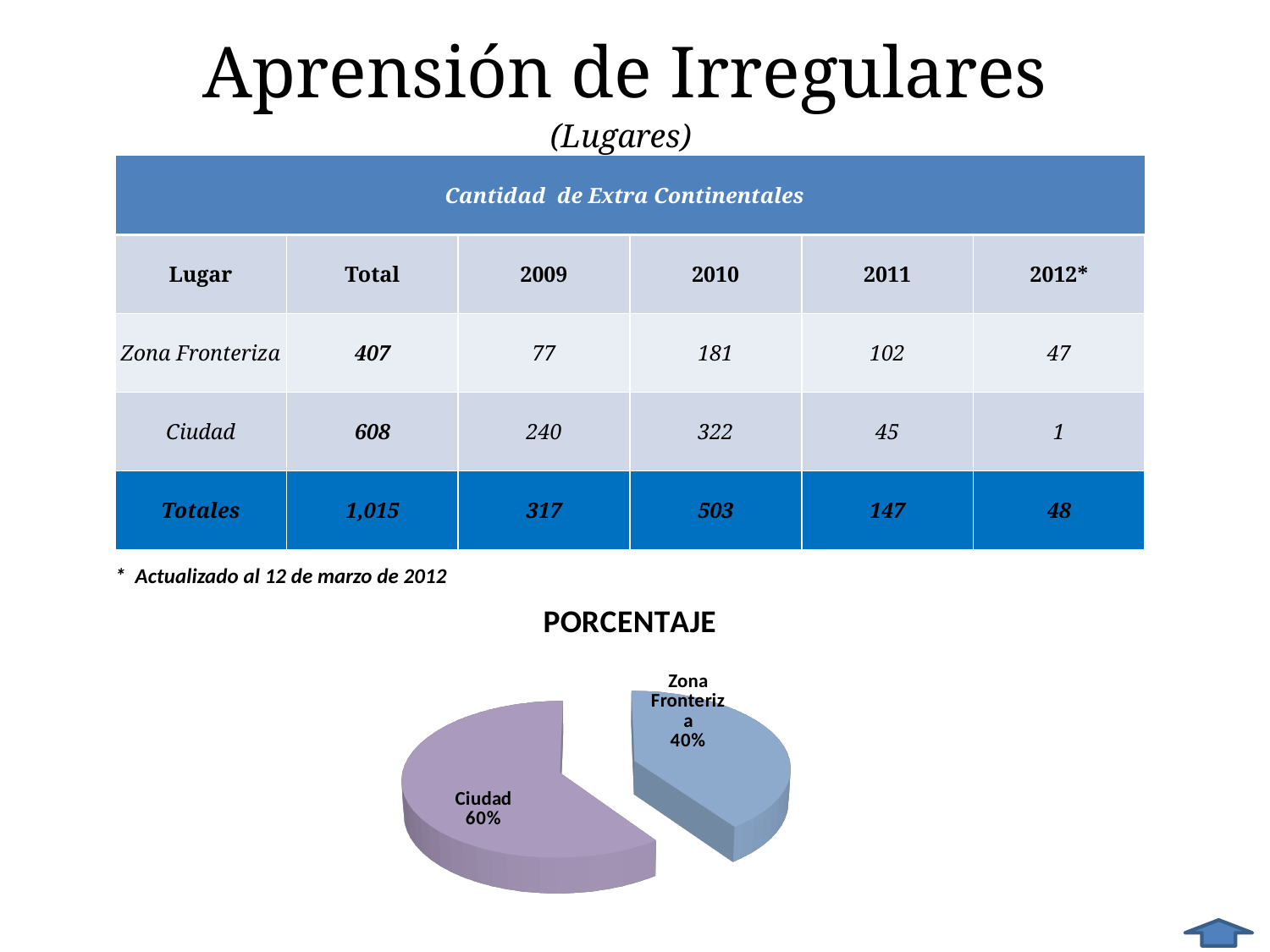
Which slice of the pie chart is the largest? Ciudad What colour is the Ciudad slice in the pie chart? purple Is the Zona Fronteriza share in the pie chart greater or less than 50%? less What share of the pie chart does Zona Fronteriza represent? 40% What is the title of the pie chart? PORCENTAJE What share of the pie chart does Ciudad represent? 60% What is the difference in percentage points between the Ciudad slice and the Zona Fronteriza slice in the pie chart? 20 percentage points How many slices does the pie chart have? 2 What kind of chart is shown under the heading PORCENTAJE? pie chart Which slice of the pie chart is the smallest? Zona Fronteriza In the pie chart, which is larger, Ciudad or Zona Fronteriza? Ciudad